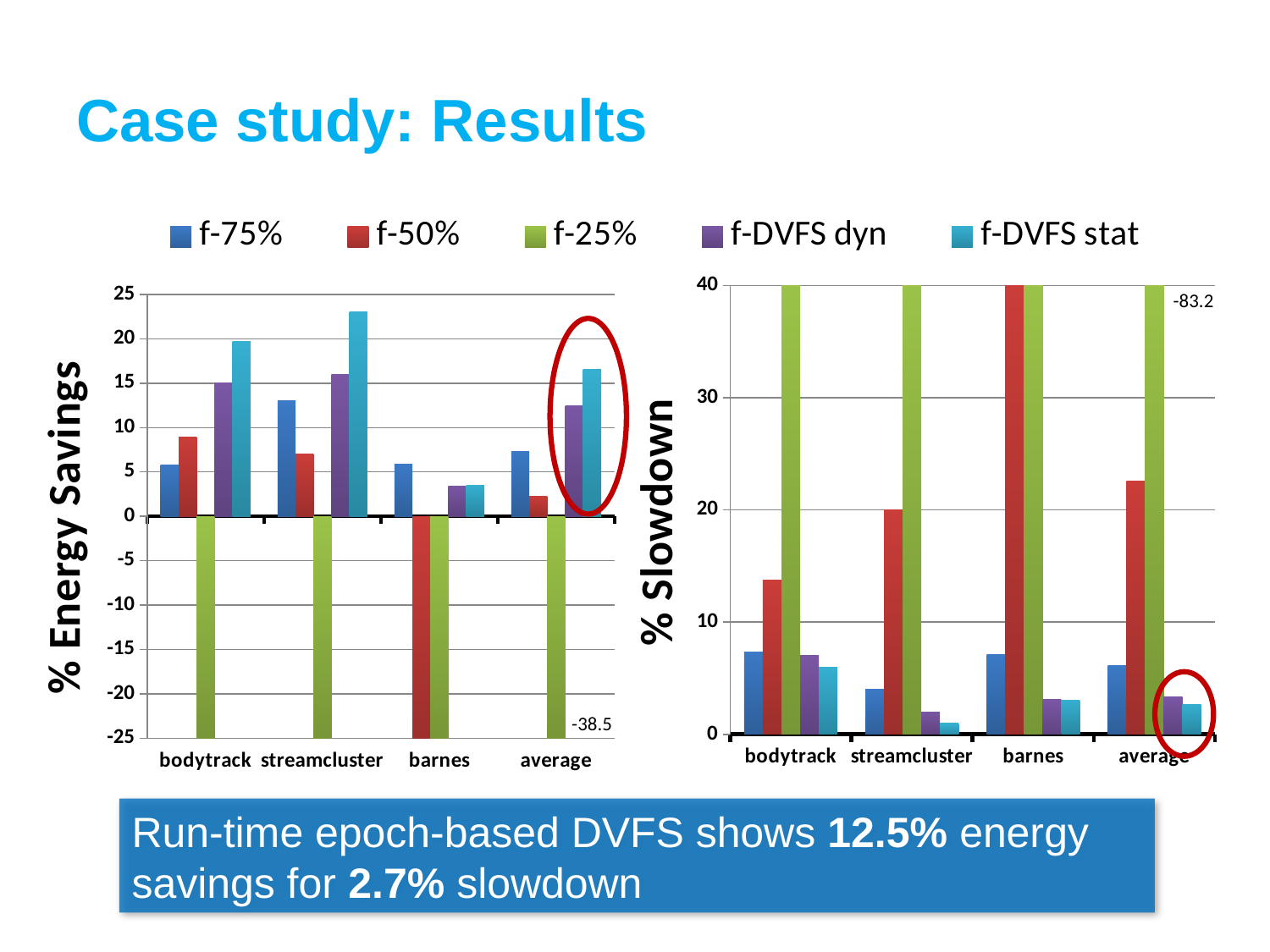
What kind of chart is the % Energy Savings chart on the left? bar chart How many categories are shown on the x axis of the % Slowdown chart on the right? 4 How many series does the legend list? 5 In the % Slowdown chart on the right, is the f-50% value for bodytrack greater or less than 10? greater In the % Energy Savings chart on the left, which category has the highest f-DVFS stat bar? streamcluster In the % Slowdown chart on the right, is the f-50% value for average greater or less than 20? greater In the % Energy Savings chart on the left, which is larger for bodytrack: f-DVFS dyn or f-DVFS stat? f-DVFS stat In the % Slowdown chart on the right, what value is printed for the f-25% bar in the average category? -83.2 What is the y-axis title of the chart on the left? % Energy Savings In the % Energy Savings chart on the left, what value is printed for the f-25% bar in the average category? -38.5 In the % Slowdown chart on the right, which category has the lowest f-DVFS stat bar? streamcluster In the % Energy Savings chart on the left, is the f-DVFS stat value for streamcluster greater or less than 20? greater